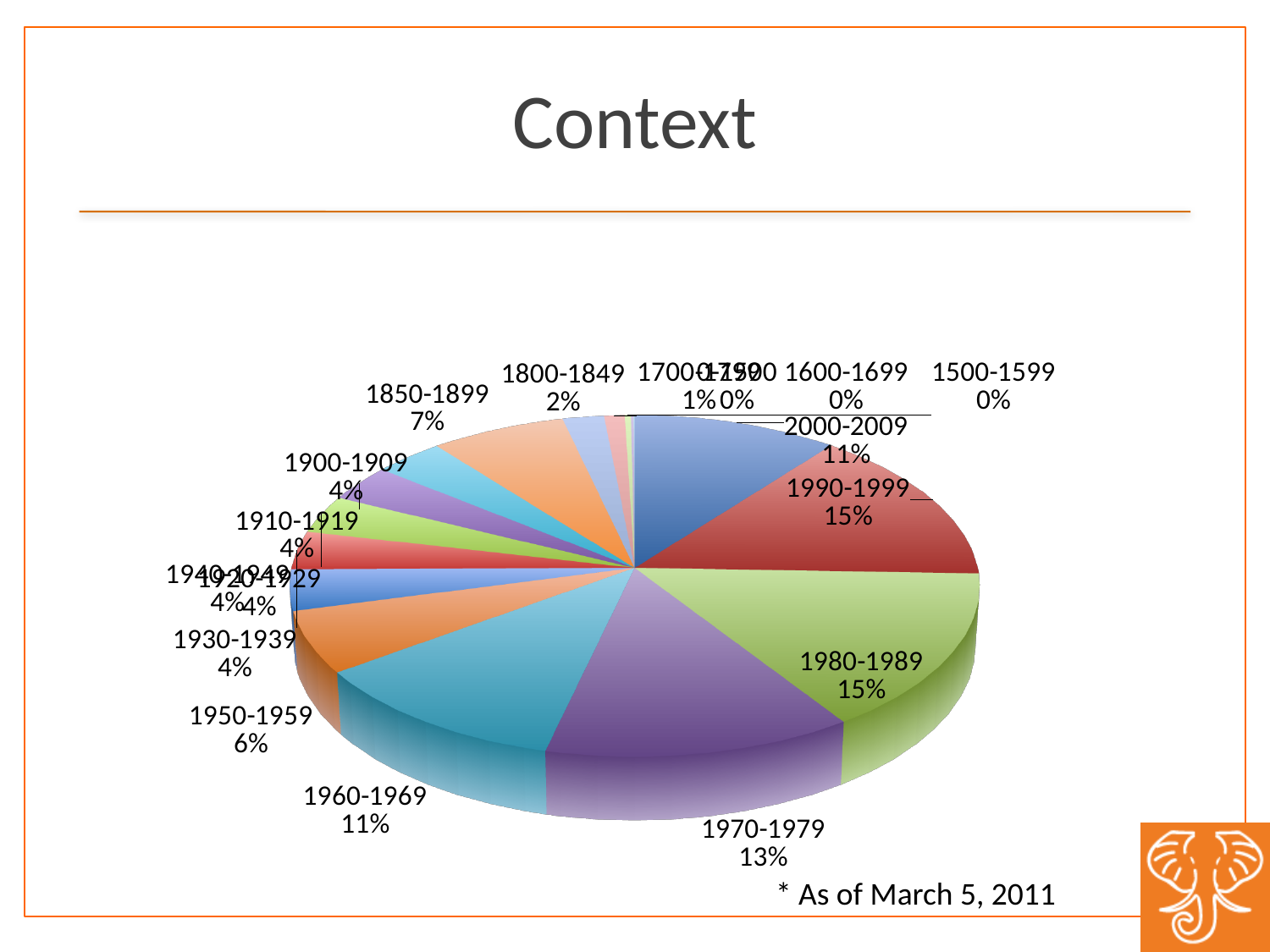
What percentage is shown for 1980-1989? 15% What percentage is shown for 1930-1939? 4% What share of the pie does the 1970-1979 slice represent? 13% What percentage is shown for 1960-1969? 11% What percentage is shown for 2000-2009? 11% What percentage is shown for 1950-1959? 6% Which has the larger share, 1970-1979 or 1960-1969? 1970-1979 What kind of chart is shown on the slide? pie chart What is the title of the slide containing the pie chart? Context What is the difference in percentage points between the 1980-1989 share and the 1950-1959 share? 9 percentage points What percentage is shown for 1800-1849? 2% What percentage is shown for 1850-1899? 7%